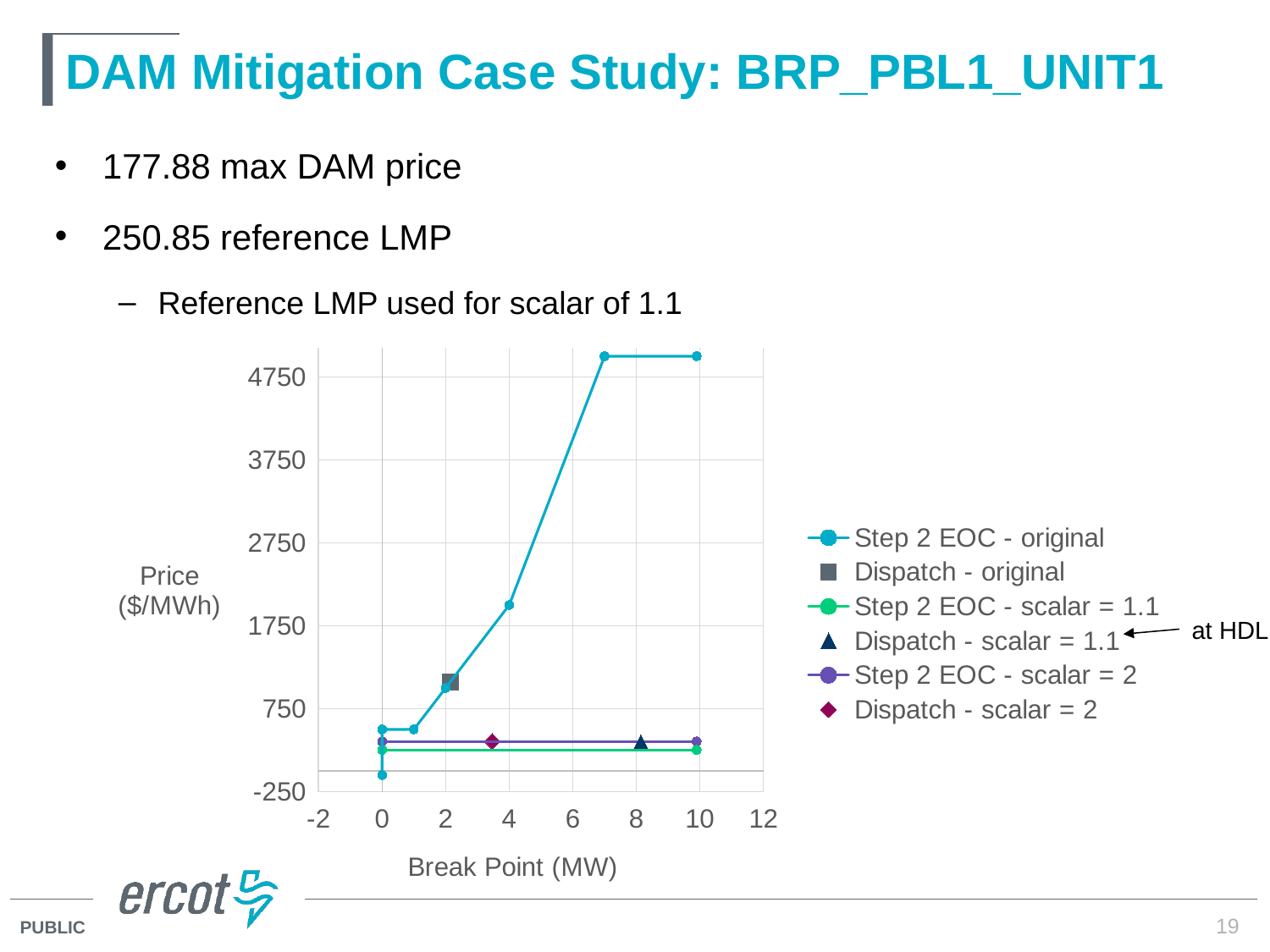
At a break point of 2 MW, which series has the larger value: Step 2 EOC - original or Step 2 EOC - scalar = 1.1? Step 2 EOC - original What is the label of the x axis of the chart? Break Point (MW) Is the value of Step 2 EOC - original at a break point of 10 MW greater or less than 4750? greater At a break point of 10 MW, which series has the larger value: Step 2 EOC - original or Step 2 EOC - scalar = 2? Step 2 EOC - original Does the Step 2 EOC - original series rise or fall as Break Point (MW) increases from 0 to 10? rise Is the value of Step 2 EOC - original at a break point of 4 MW greater or less than 1750? greater Which series reaches the highest price on the chart? Step 2 EOC - original How many series does the chart legend list? 6 What is the label of the y axis of the chart? Price ($/MWh) Is the value of Step 2 EOC - scalar = 1.1 at a break point of 10 MW greater or less than 750? less What kind of chart is shown on the slide? line chart